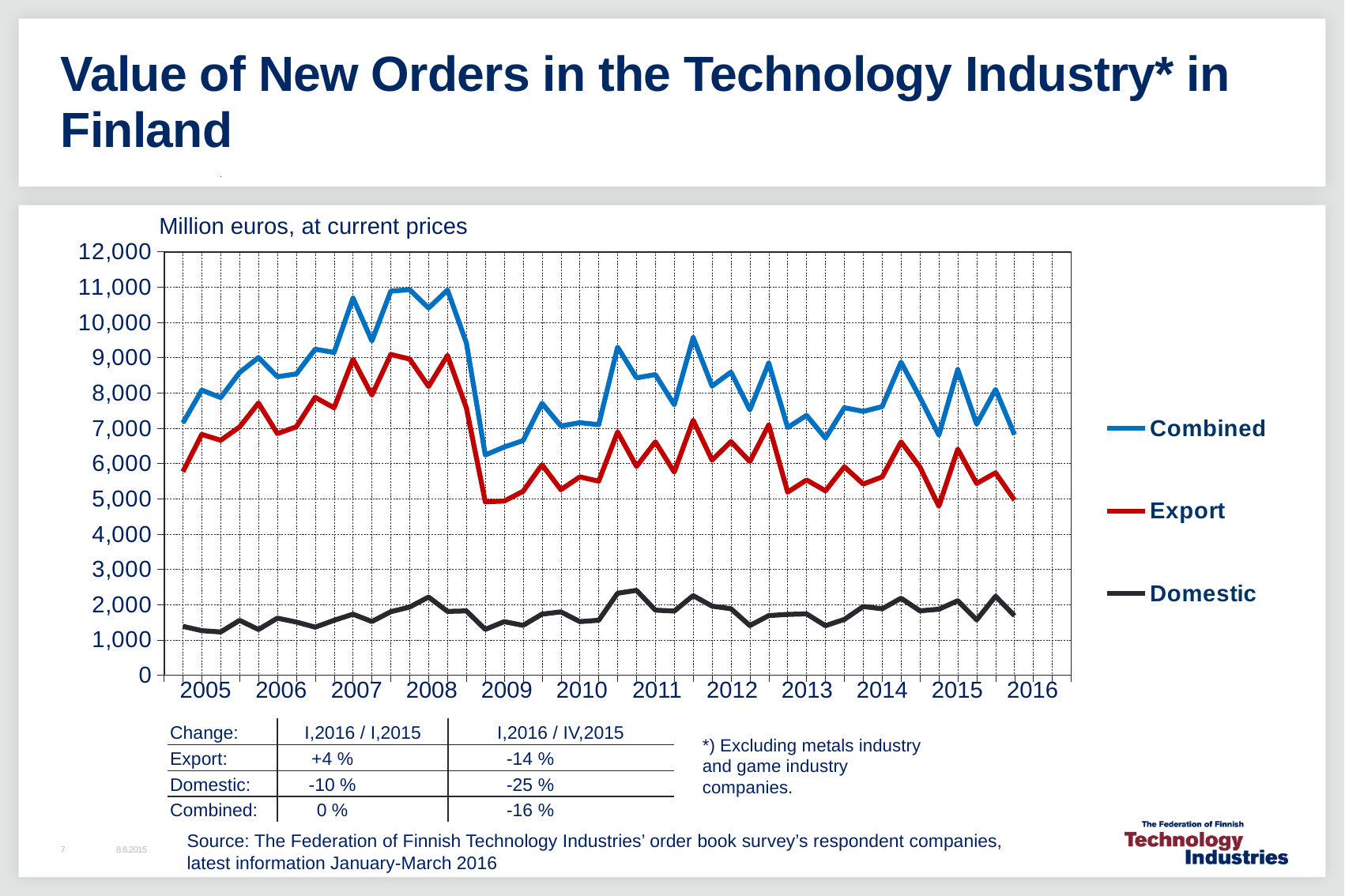
How many series does the legend list? 3 How many year labels appear on the x axis? 12 What unit is stated above the chart? Million euros, at current prices Is the value of the Export series at its low point in 2009 greater or less than 6,000? less Is the highest value of the Domestic series greater or less than 3,000? less Which is larger in 2010, the Export series or the Domestic series? Export What kind of chart is shown on the slide? line chart Which series has the lowest values throughout the chart? Domestic What are the three series named in the legend? Combined, Export, Domestic Does the Combined series rise or fall between 2008 and 2009? fall Which series has the highest values throughout the chart? Combined Is the peak value of the Combined series in 2008 greater or less than 10,000? greater